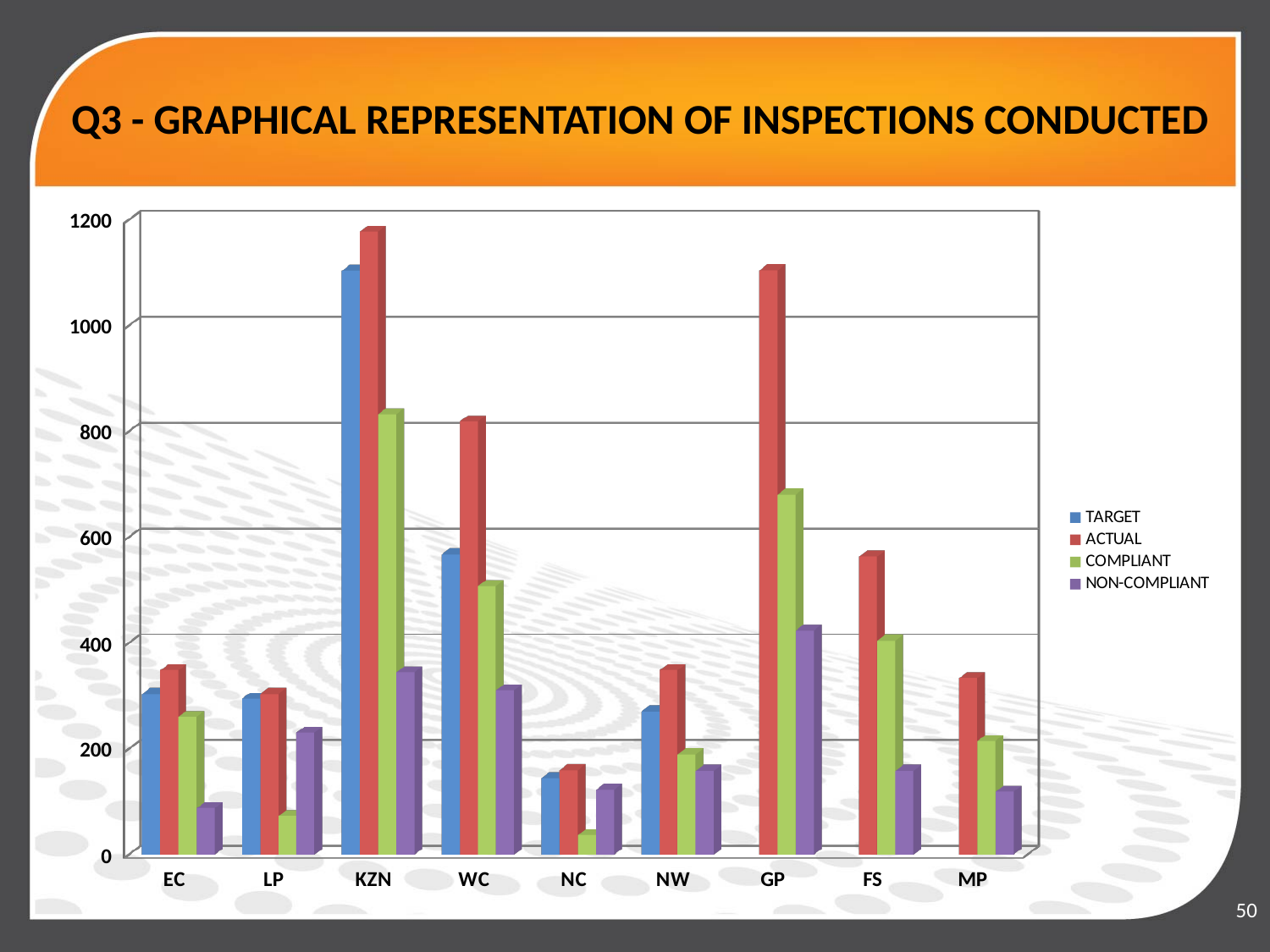
How many provinces (categories) are shown on the x axis? 9 What colour represents the ACTUAL series in the legend? Red What kind of chart is shown on the slide? Bar chart How many series does the legend list? 4 For LP, which is larger, the COMPLIANT value or the NON-COMPLIANT value? NON-COMPLIANT Which province has the highest ACTUAL value? KZN Which province has the lowest COMPLIANT value? NC Which province has the highest NON-COMPLIANT value? GP Which is larger, the ACTUAL value for GP or the ACTUAL value for FS? GP Is the COMPLIANT value for GP greater or less than 600? greater Is the ACTUAL value for WC greater or less than 600? greater Is the TARGET value for KZN greater or less than 1000? greater